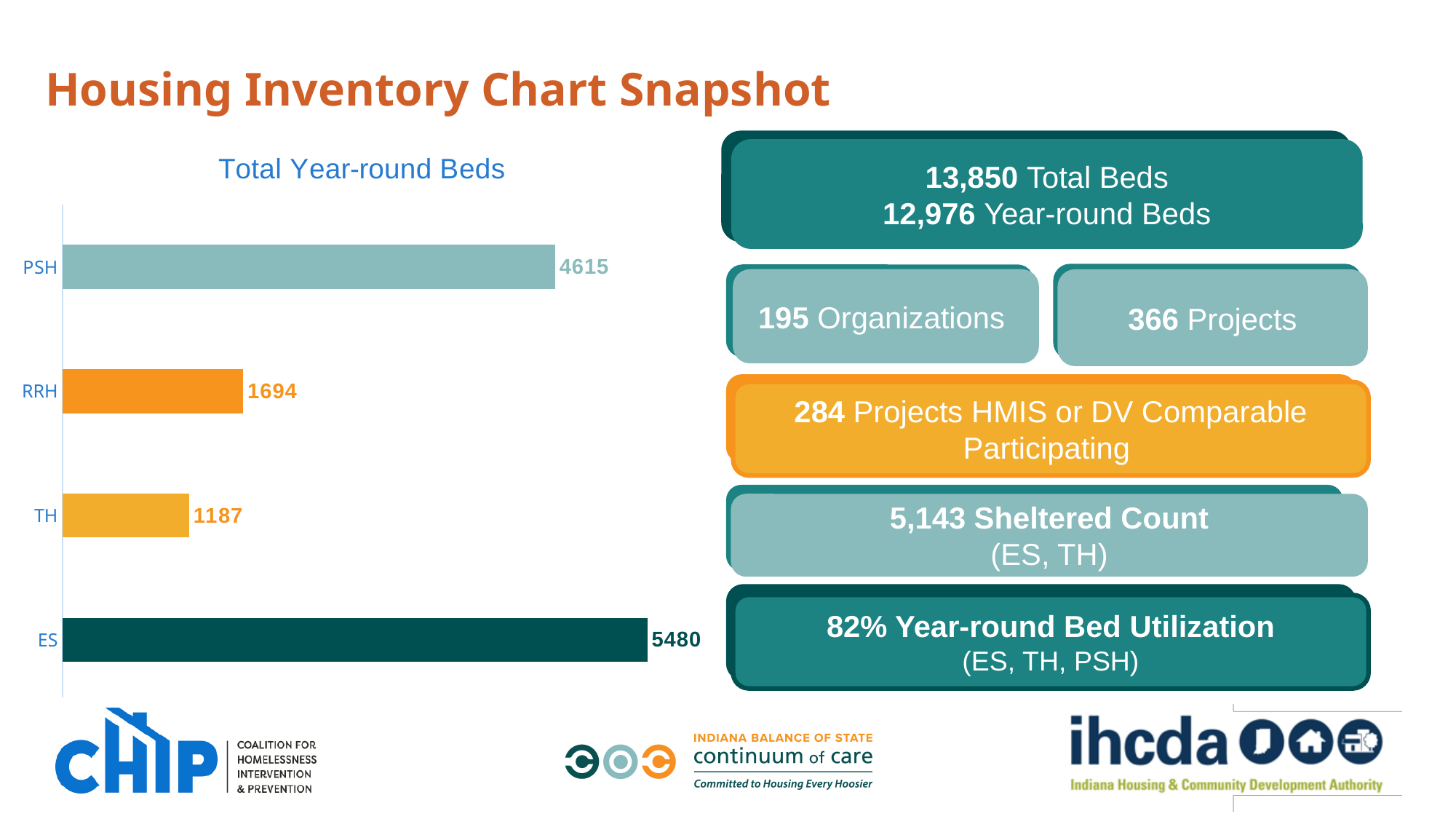
Which category has the highest value in the Total Year-round Beds chart? ES What is the value for PSH in the Total Year-round Beds chart? 4615 What kind of chart is the Total Year-round Beds chart? Bar chart What is the title of the chart on the slide? Total Year-round Beds What is the value for RRH in the Total Year-round Beds chart? 1694 How many categories are shown in the Total Year-round Beds chart? 4 What is the value for TH in the Total Year-round Beds chart? 1187 What is the difference between the RRH and TH values in the Total Year-round Beds chart? 507 Which category has the lowest value in the Total Year-round Beds chart? TH What is the difference between the ES and PSH values in the Total Year-round Beds chart? 865 What is the value for ES in the Total Year-round Beds chart? 5480 Which is larger in the Total Year-round Beds chart, RRH or TH? RRH